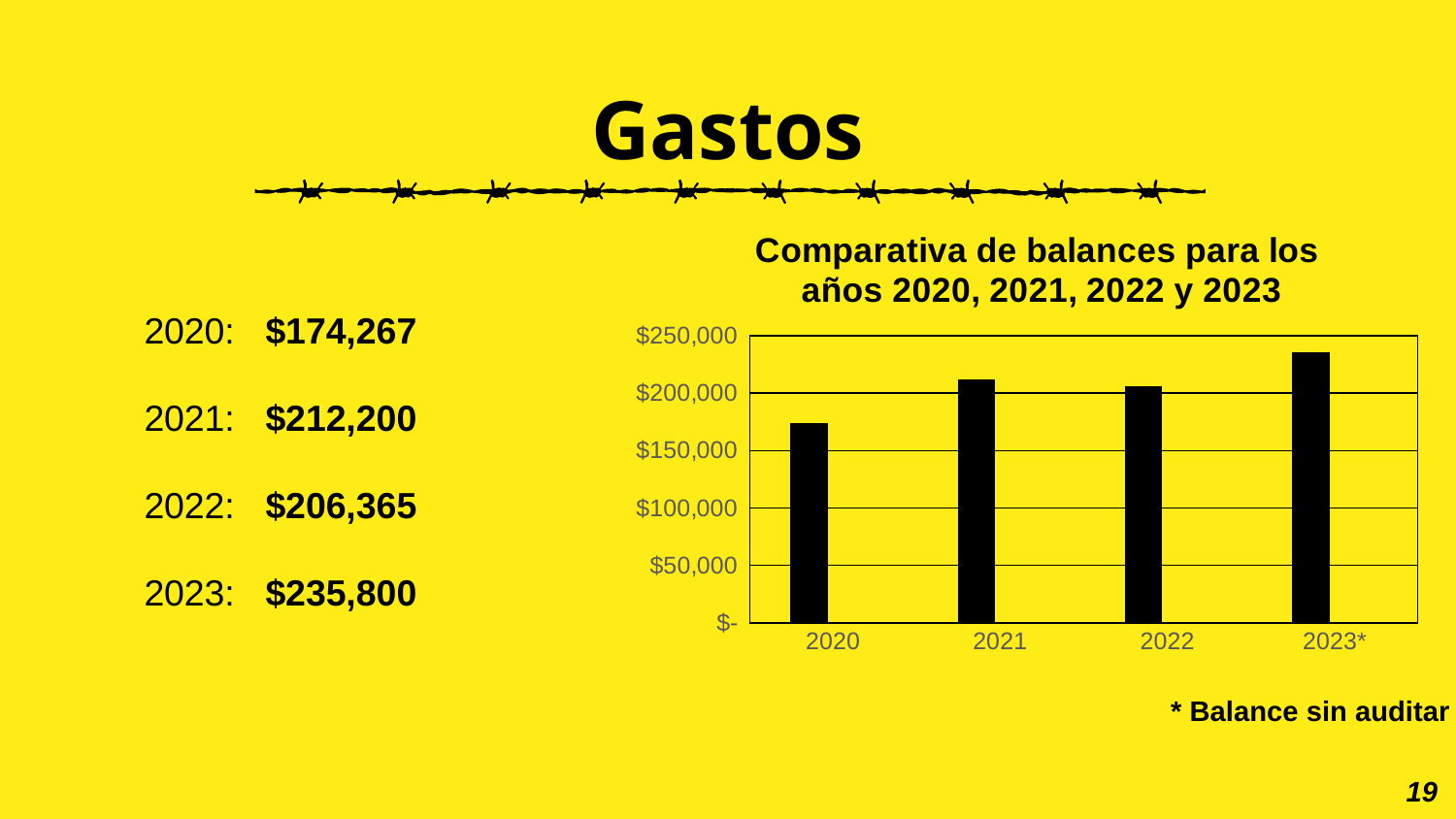
What is the title of the chart? Comparativa de balances para los años 2020, 2021, 2022 y 2023 Is the value for 2020 greater or less than $200,000? less Which is larger, the value for 2021 or the value for 2022? 2021 What type of chart is shown on the slide? bar chart What is the difference between the values for 2023 and 2020? $61,533 What is the value for 2023? $235,800 How many years (bars) are shown in the chart? 4 Which year has the lowest value? 2020 Which year has the highest value? 2023 What is the value for 2020? $174,267 What is the value for 2022? $206,365 What is the value for 2021? $212,200